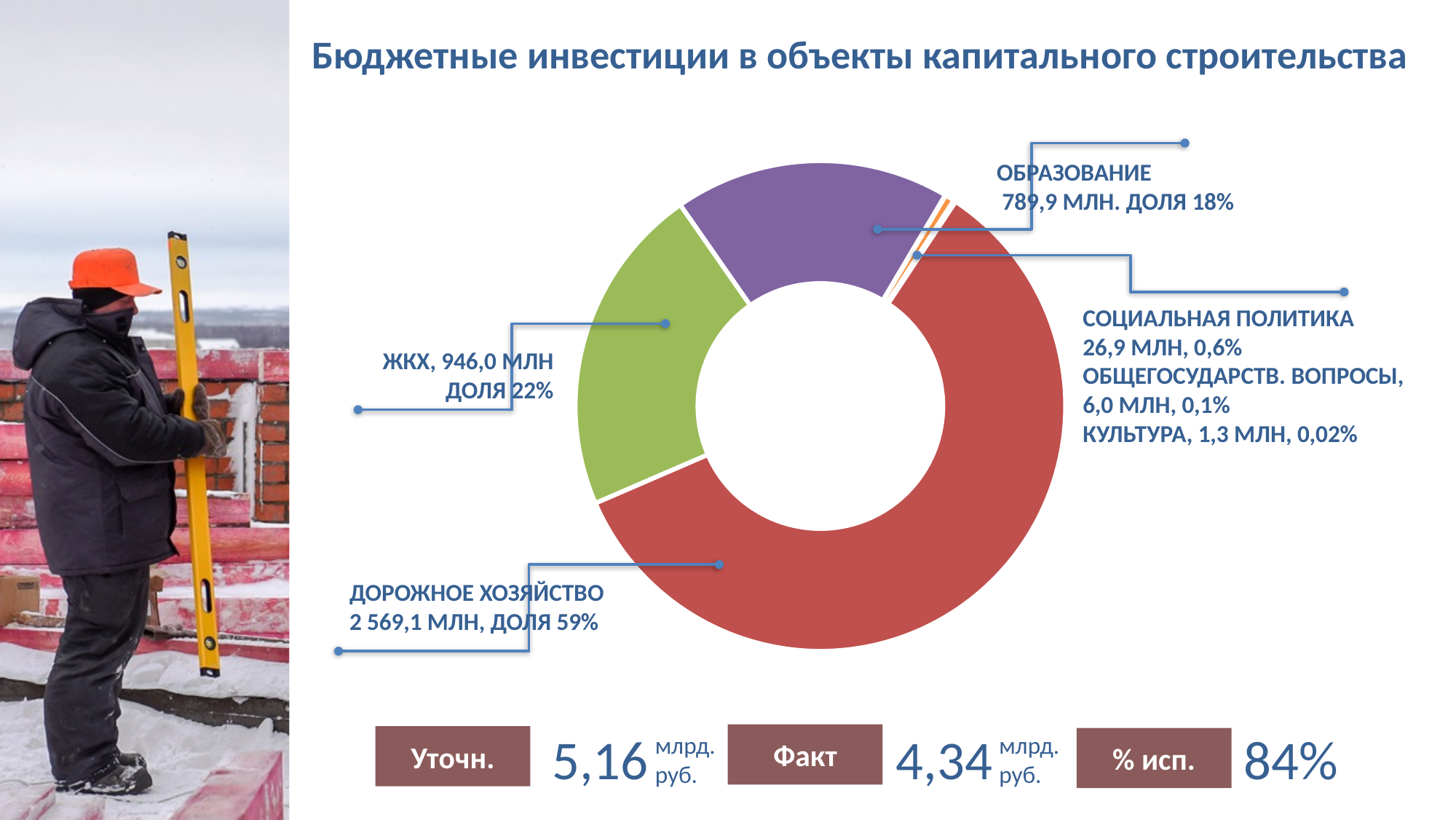
How many categories are shown in the chart? 6 Which category has the largest value? Дорожное хозяйство Which category has the smallest value? Культура What share does ЖКХ have in the chart? 22% What is the value for Социальная политика? 26,9 млн What is the value for Дорожное хозяйство? 2 569,1 млн What is the value for Образование? 789,9 млн What kind of chart is shown on the slide? Pie (donut) chart What is the value for ЖКХ? 946,0 млн What share does Культура have in the chart? 0,02% What share does Дорожное хозяйство have in the chart? 59%